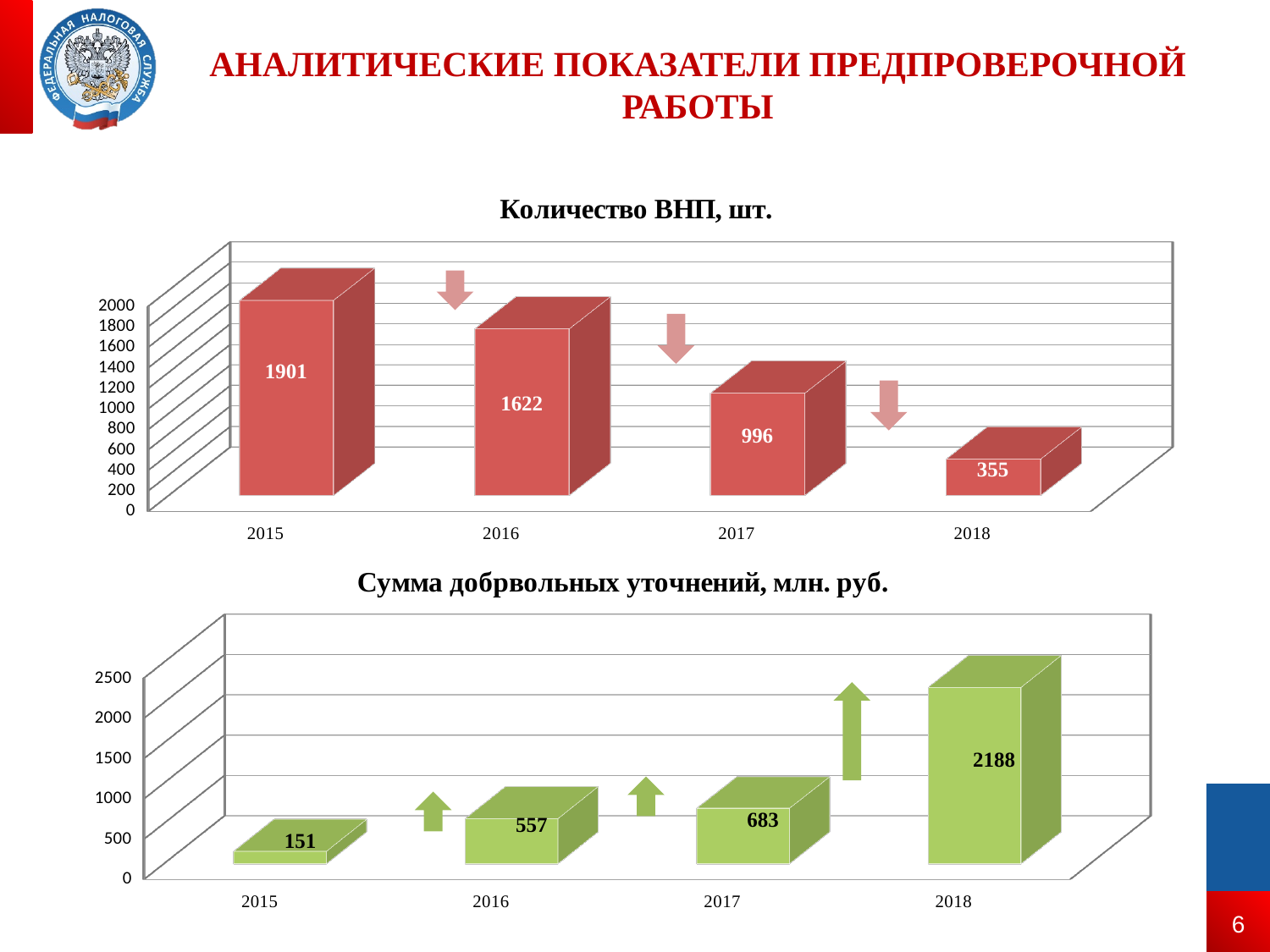
What kind of chart is the top chart on the slide? bar chart In the chart titled "Количество ВНП, шт.", which year has the lowest value? 2018 In the chart titled "Сумма добрвольных уточнений, млн. руб.", what is the value for 2017? 683 In the chart titled "Количество ВНП, шт.", what is the difference between the values for 2015 and 2018? 1546 In the chart titled "Сумма добрвольных уточнений, млн. руб.", which year has the highest value? 2018 In the chart titled "Сумма добрвольных уточнений, млн. руб.", what is the difference between the values for 2018 and 2017? 1505 In the chart titled "Количество ВНП, шт.", what is the value for 2016? 1622 In the chart titled "Количество ВНП, шт.", how many years are shown on the x axis? 4 What colour are the bars in the bottom chart? green In the chart titled "Сумма добрвольных уточнений, млн. руб.", which is larger, the value for 2016 or the value for 2015? 2016 In the chart titled "Сумма добрвольных уточнений, млн. руб.", do the values rise or fall from 2015 to 2018? rise In the chart titled "Количество ВНП, шт.", do the values rise or fall from 2015 to 2018? fall